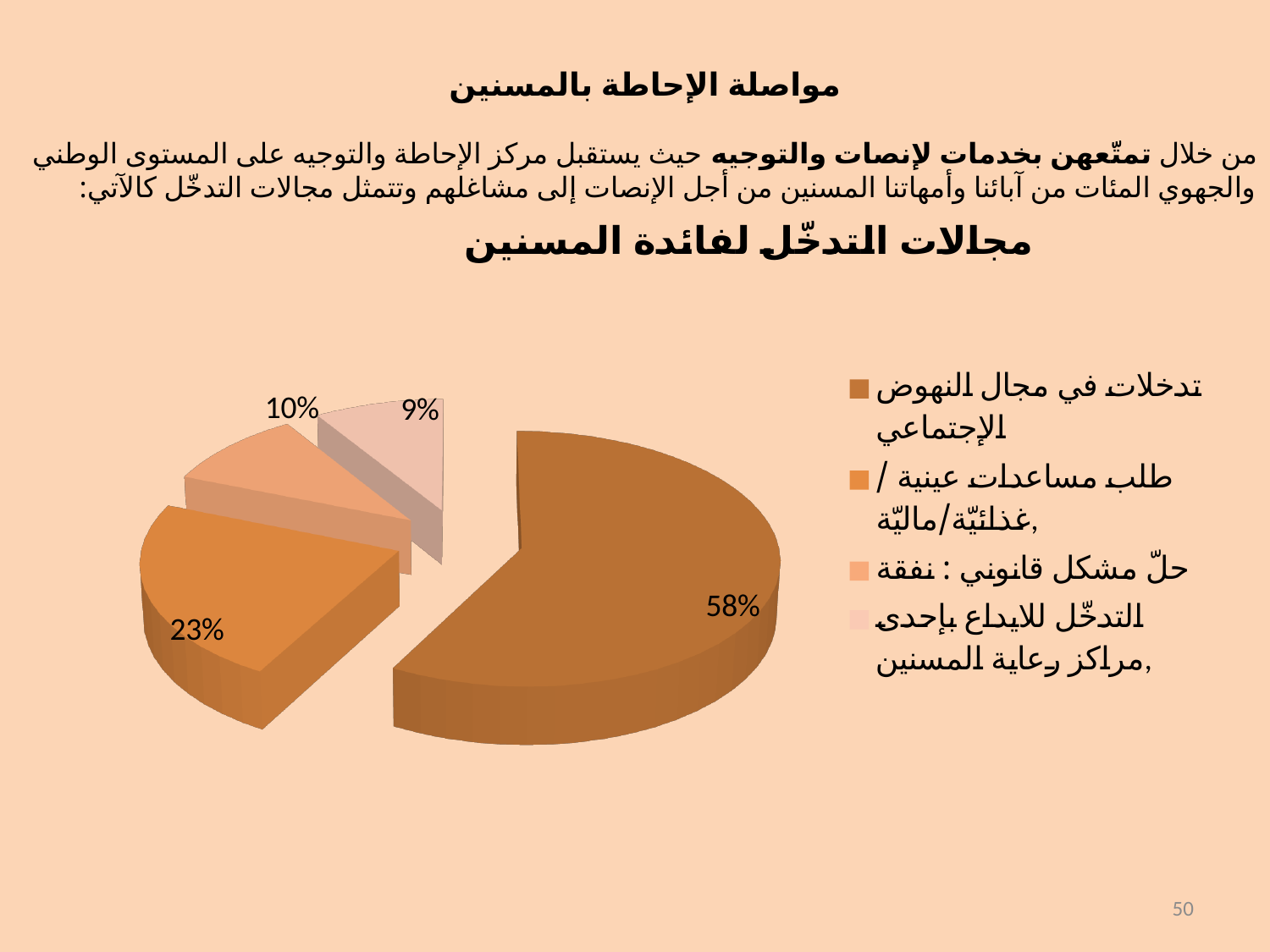
What is the title of the chart? مجالات التدخّل لفائدة المسنين How many entries does the legend list? 4 What share of the pie is labelled for 'طلب مساعدات عينية / غذائيّة/ماليّة'? 23% What share of the pie is labelled for 'تدخلات في مجال النهوض الإجتماعي'? 58% What share of the pie is labelled for 'التدخّل للايداع بإحدى مراكز رعاية المسنين'? 9% Which is larger: the slice for 'حلّ مشكل قانوني : نفقة' or the slice for 'طلب مساعدات عينية / غذائيّة/ماليّة'? طلب مساعدات عينية / غذائيّة/ماليّة What kind of chart is shown on the slide? pie chart What is the difference in percentage points between the largest slice (58%) and the slice for 'طلب مساعدات عينية / غذائيّة/ماليّة' (23%)? 35 Which category has the largest slice of the pie? تدخلات في مجال النهوض الإجتماعي Which category has the smallest slice of the pie? التدخّل للايداع بإحدى مراكز رعاية المسنين How many slices does the pie chart have? 4